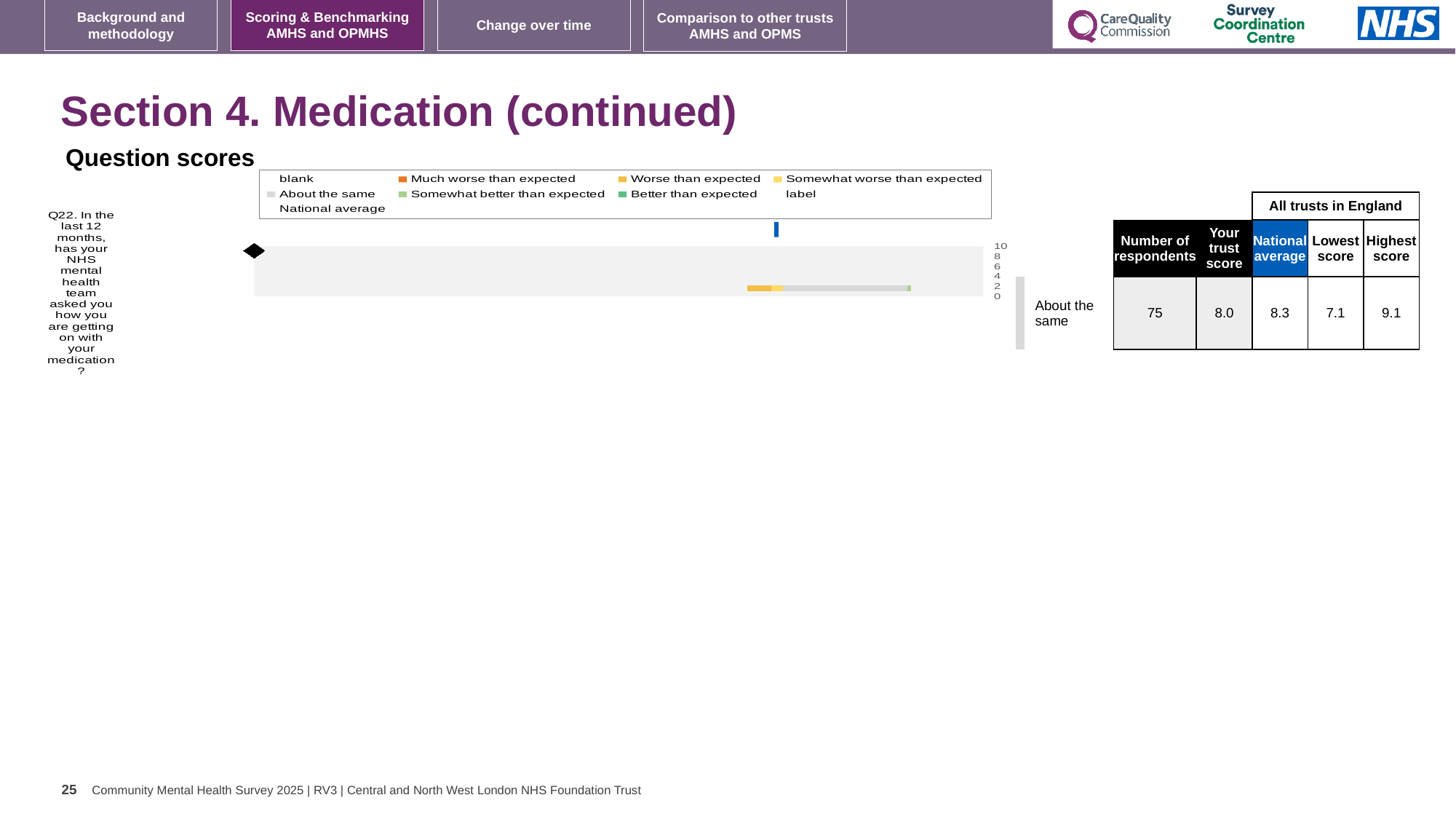
In the table beside the chart, what is the lowest score among all trusts in England for Q22? 7.1 In the table beside the chart, what is the number of respondents for Q22? 75 What benchmark category is shown for Q22 next to the chart? About the same Which question number is plotted in the Question scores chart? Q22 In the table beside the chart, what is 'Your trust score' for Q22? 8.0 In the table beside the chart, what is the national average for Q22? 8.3 Which is larger for Q22, the trust score or the national average? national average How many survey questions are plotted in the Question scores chart? 1 What kind of chart is shown under 'Question scores'? bar chart In the table beside the chart, what is the highest score among all trusts in England for Q22? 9.1 How many entries does the legend of the Question scores chart list? 9 What is the difference between the highest score and the lowest score for Q22? 2.0